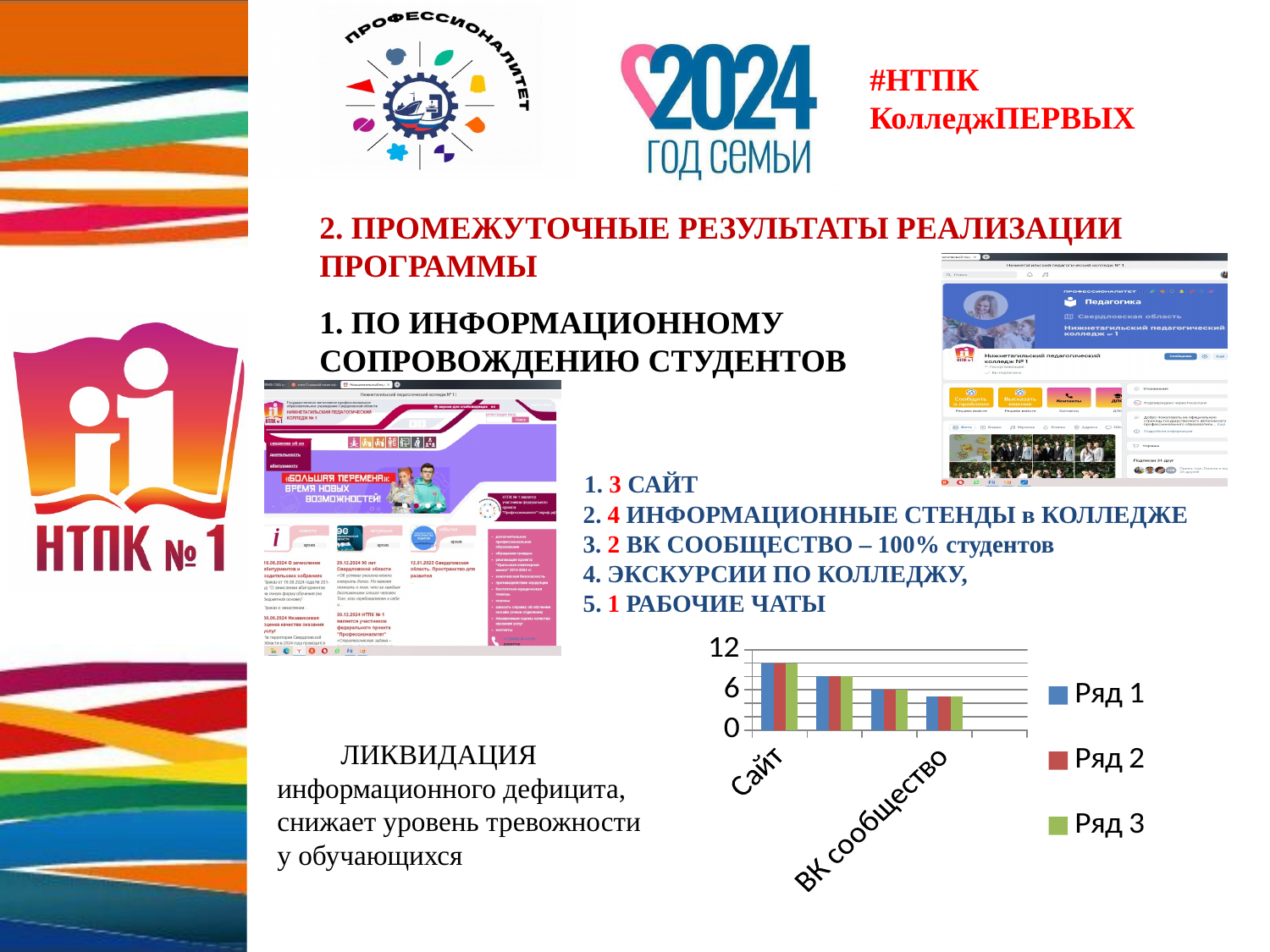
In the bar chart, is the value of Ряд 1 for Сайт greater or less than 6? greater What are the legend entries of the bar chart? Ряд 1, Ряд 2, Ряд 3 In the bar chart, is the value of Ряд 2 for Сайт greater or less than 12? less Which category has the highest bars in the bar chart? Сайт Do the values in the bar chart rise or fall from left to right along the x axis? fall What is the highest tick value shown on the vertical axis of the bar chart? 12 How many series does the legend of the bar chart list? 3 In the bar chart, is the value of Ряд 3 for Сайт greater or less than 6? greater How many groups of bars are plotted in the bar chart? 4 What kind of chart is shown at the bottom right of the slide? bar chart